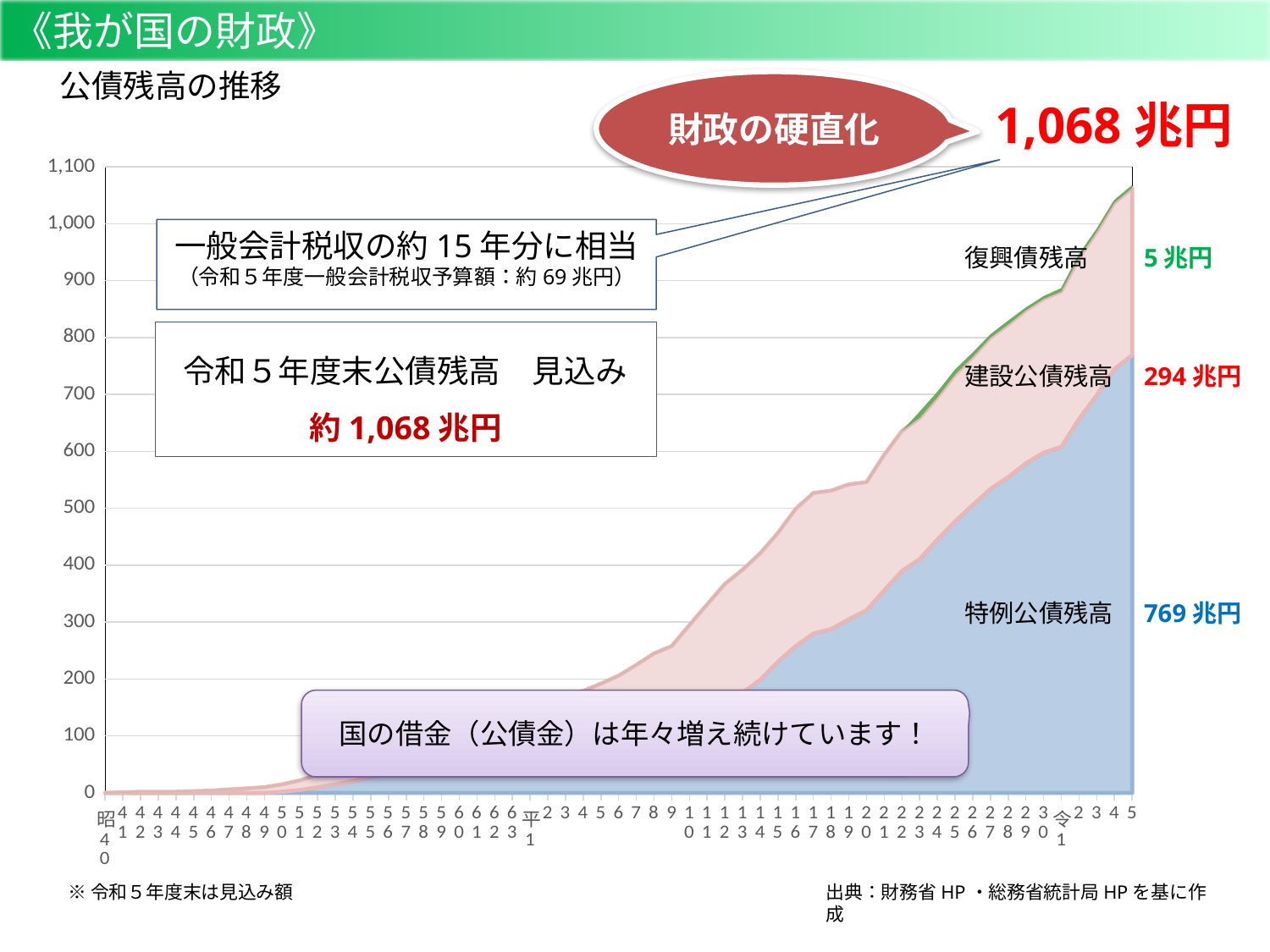
Does the total 公債残高 rise or fall over time along the x axis? rise What is the title of the chart? 公債残高の推移 What is the total 公債残高 shown for the end of 令和5年度? 1,068兆円 Which of the three bond categories has the smallest balance at the end of 令和5年度? 復興債残高 Which of the three bond categories has the largest balance at the end of 令和5年度? 特例公債残高 What is the value labelled for 建設公債残高 at the right end of the chart? 294兆円 What is the value labelled for 特例公債残高 at the right end of the chart? 769兆円 How many bond categories (series) are stacked in the chart? 3 What is the value labelled for 復興債残高 at the right end of the chart? 5兆円 What is the difference between the 特例公債残高 and the 建設公債残高 values shown? 475兆円 Which is larger at the end of 令和5年度, 建設公債残高 or 復興債残高? 建設公債残高 What kind of chart is shown on the slide? area chart